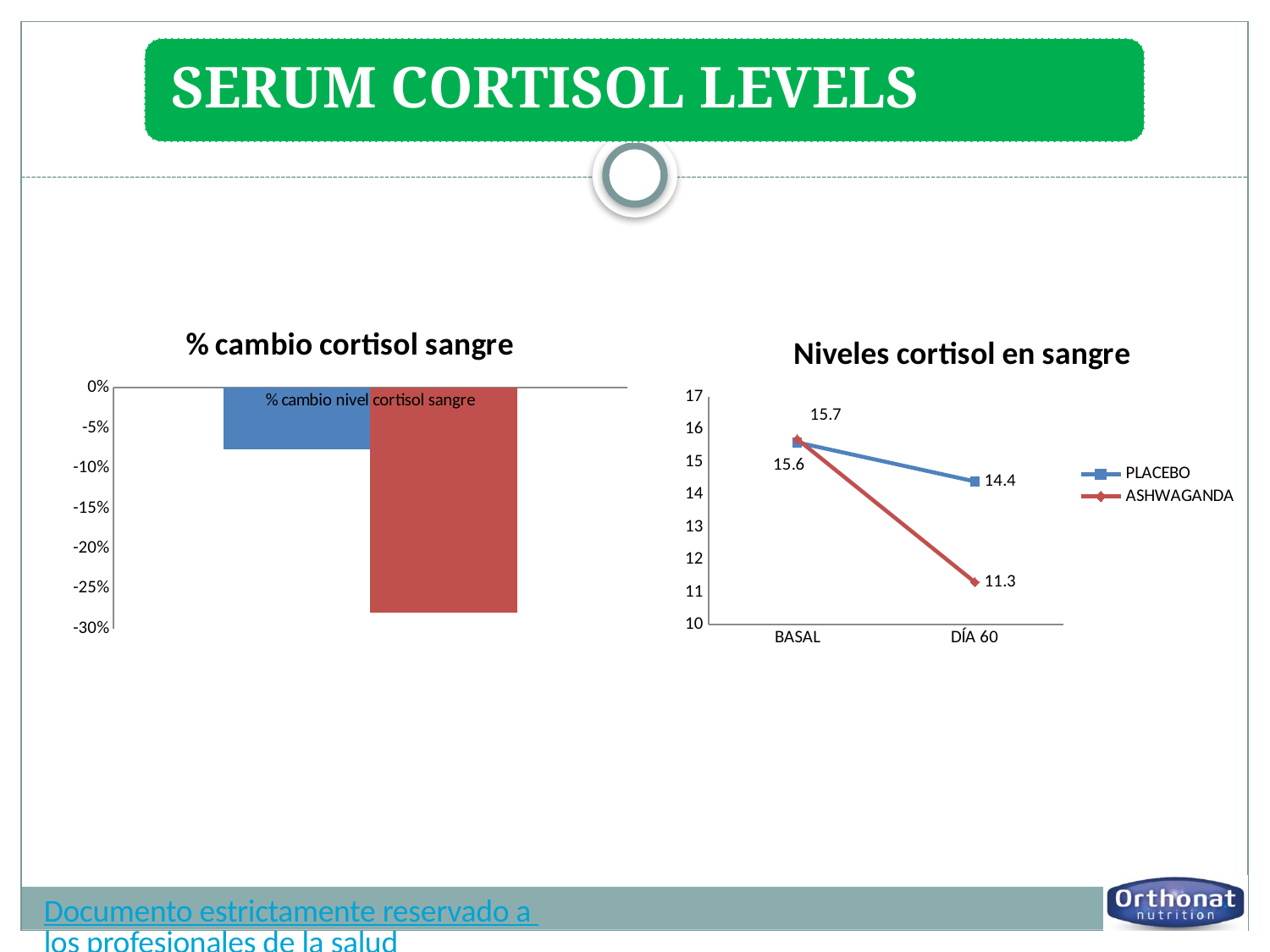
What type of chart is the left chart titled '% cambio cortisol sangre'? bar chart In the right chart 'Niveles cortisol en sangre', what is the ASHWAGANDA value at BASAL? 15.7 In the right chart 'Niveles cortisol en sangre', what is the difference between the PLACEBO and ASHWAGANDA values at DÍA 60? 3.1 In the right chart 'Niveles cortisol en sangre', what is the PLACEBO value at BASAL? 15.6 In the left chart '% cambio cortisol sangre', is the value of the blue bar greater or less than -10%? greater In the right chart 'Niveles cortisol en sangre', what is the PLACEBO value at DÍA 60? 14.4 In the left chart '% cambio cortisol sangre', how many bars are plotted? 2 In the right chart 'Niveles cortisol en sangre', what is the ASHWAGANDA value at DÍA 60? 11.3 In the right chart 'Niveles cortisol en sangre', how many series does the legend list? 2 In the left chart '% cambio cortisol sangre', is the value of the red bar greater or less than -25%? less What type of chart is the right chart titled 'Niveles cortisol en sangre'? line chart In the right chart 'Niveles cortisol en sangre', which series has the lower value at DÍA 60? ASHWAGANDA